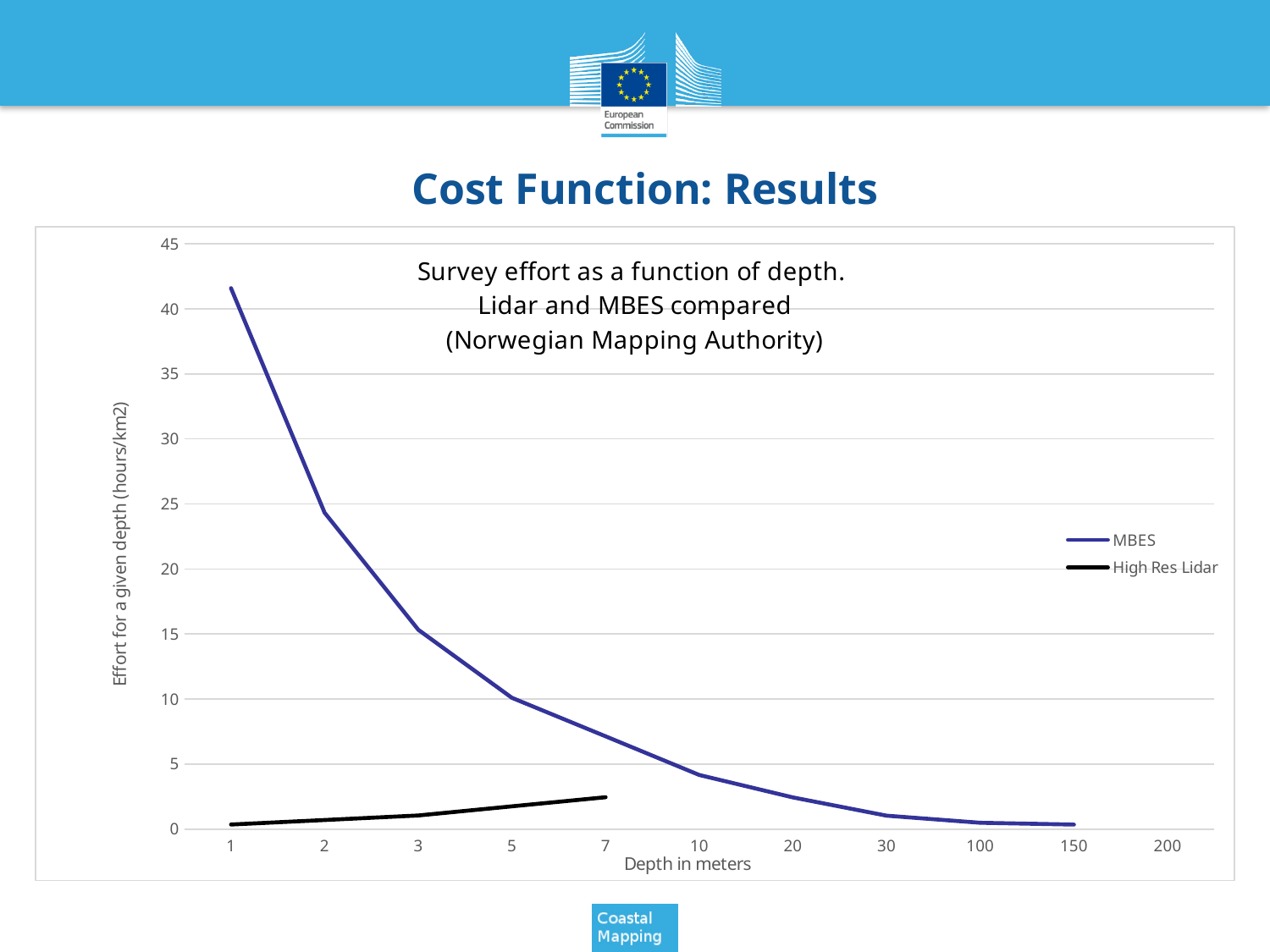
Is the MBES value at a depth of 2 meters greater or less than 25? less At a depth of 1 meter, which series has the larger effort, MBES or High Res Lidar? MBES How many series does the legend list? 2 What kind of chart is shown on the slide? line chart At which depth is the MBES effort highest? 1 How many depth values are marked along the x axis? 11 Which two series are listed in the legend? MBES and High Res Lidar Is the MBES value at a depth of 1 meter greater or less than 40? greater Is the MBES value at a depth of 10 meters greater or less than 5? less Does the MBES effort rise or fall as depth increases along the x axis? fall What is the label of the y axis? Effort for a given depth (hours/km2)